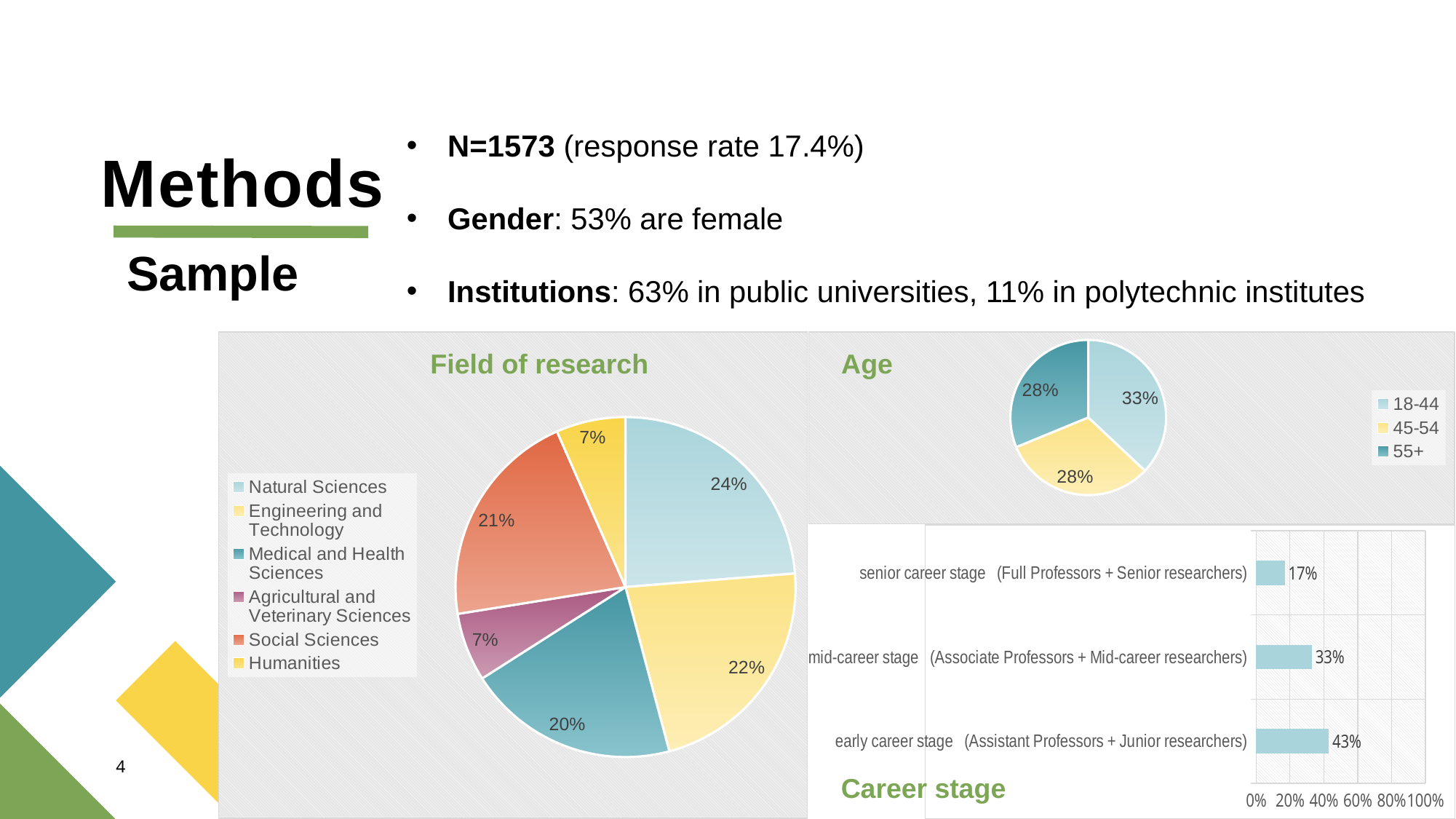
In the Age pie chart, which age group has the largest share? 18-44 In the Field of research pie chart, which field has the largest share? Natural Sciences In the Field of research pie chart, what is the difference between the Engineering and Technology share and the Medical and Health Sciences share? 2% In the Field of research pie chart, what share is Social Sciences? 21% In the Career stage chart, what is the difference between the early career stage and the senior career stage values? 26% In the Age pie chart, how many age groups does the legend list? 3 In the Career stage chart, what is the value for the early career stage? 43% In the Career stage chart, which career stage has the lowest value? senior career stage In the Field of research pie chart, what share is Natural Sciences? 24% In the Age pie chart, what share is the 18-44 group? 33% What kind of chart is the Career stage chart? bar chart In the Field of research pie chart, how many fields are listed in the legend? 6